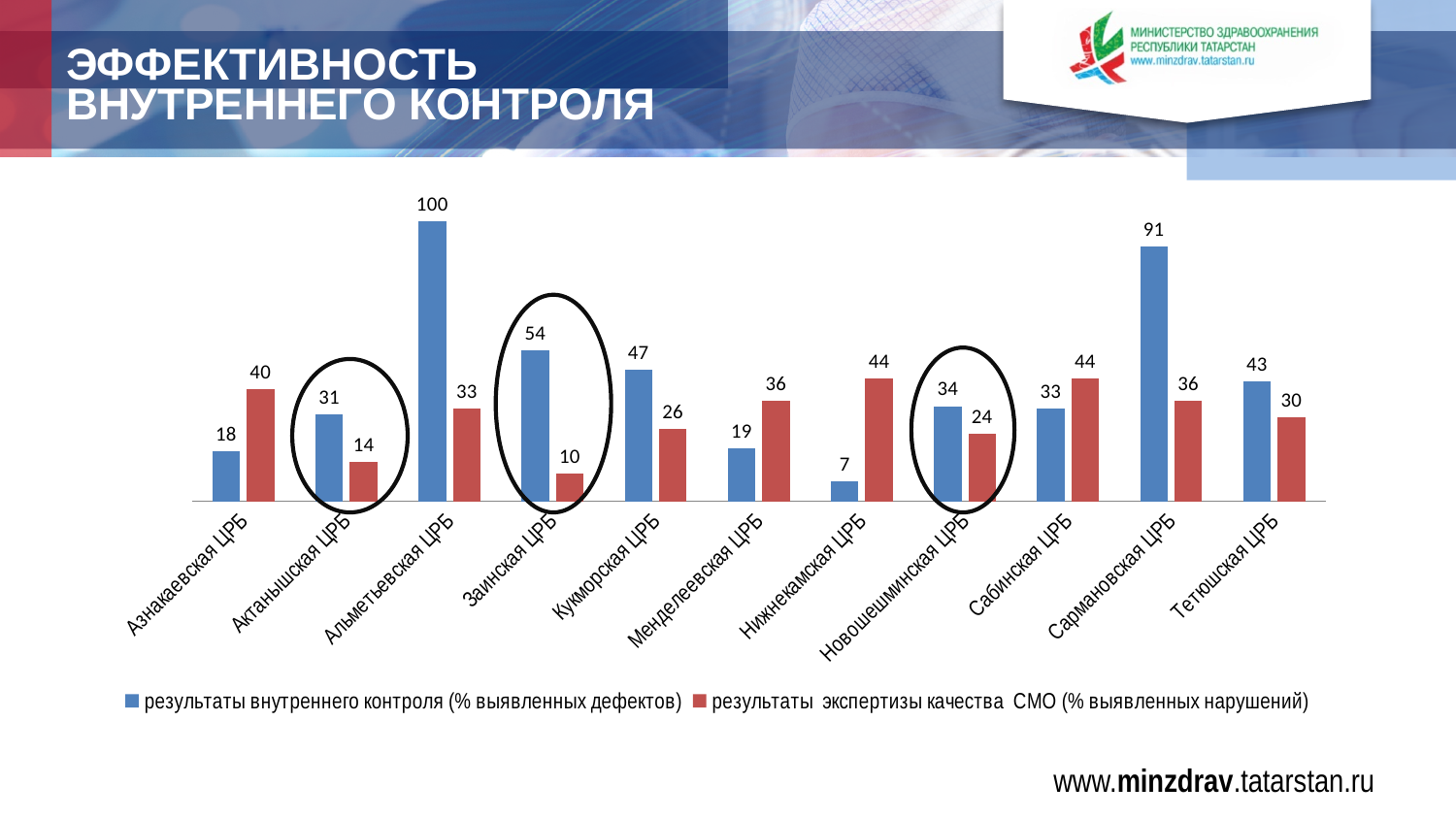
What type of chart is shown on the slide? Bar chart For Менделеевская ЦРБ, which is larger: результаты внутреннего контроля or результаты экспертизы качества СМО? результаты экспертизы качества СМО Which ЦРБ has the lowest value for результаты внутреннего контроля? Нижнекамская ЦРБ What is the value of результаты внутреннего контроля for Заинская ЦРБ? 54 How many series does the legend list? 2 Which ЦРБ has the lowest value for результаты экспертизы качества СМО? Заинская ЦРБ What is the value of результаты экспертизы качества СМО for Нижнекамская ЦРБ? 44 Which ЦРБ has the highest value for результаты внутреннего контроля? Альметьевская ЦРБ What colour are the bars for результаты экспертизы качества СМО? Red What is the value of результаты внутреннего контроля for Альметьевская ЦРБ? 100 What is the difference between the two series values for Сармановская ЦРБ? 55 How many categories (ЦРБ) are shown on the x axis? 11